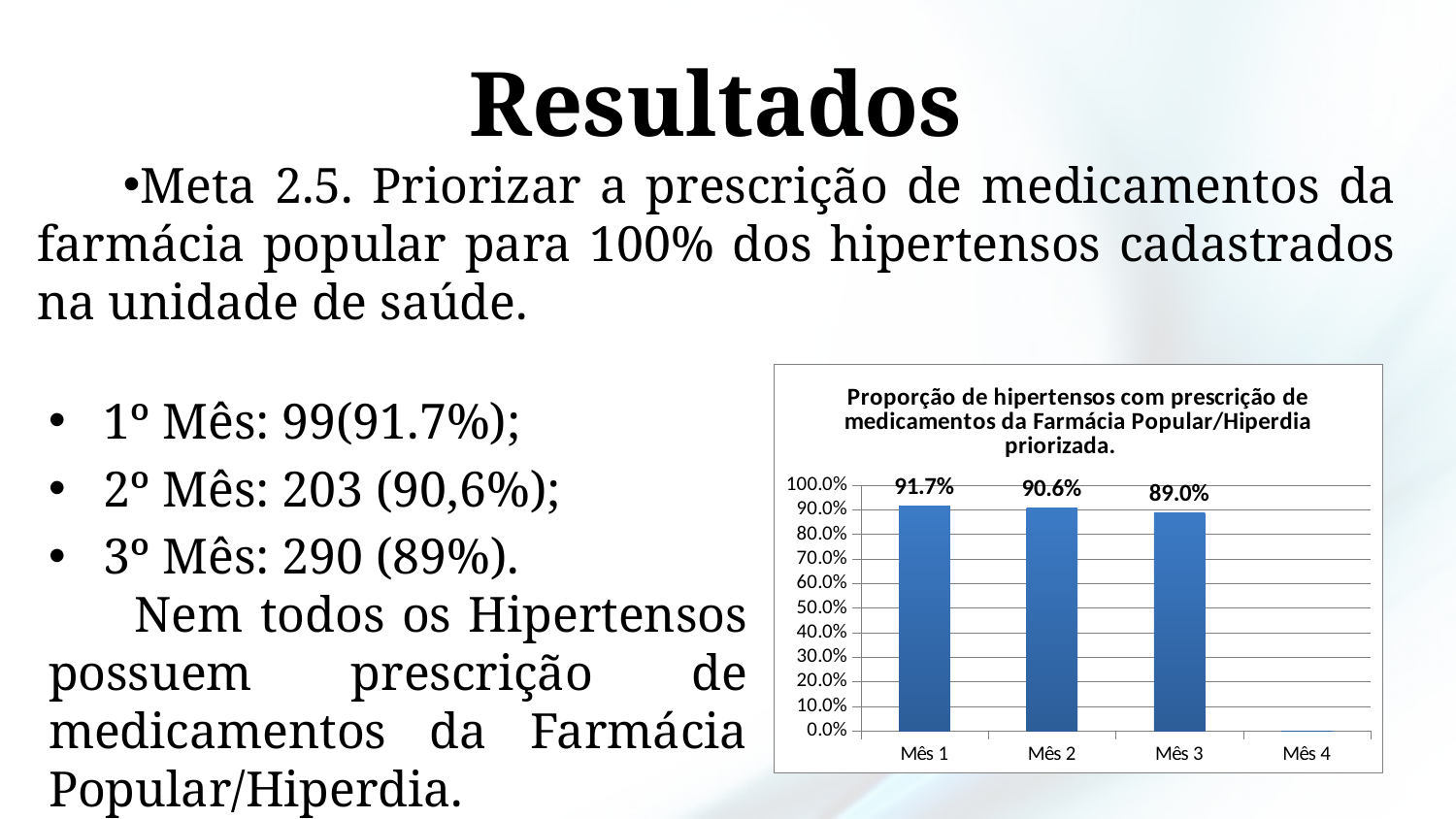
What kind of chart is shown on the slide? Bar chart Do the values rise or fall from Mês 1 to Mês 3? Fall What is the value for Mês 1? 91.7% Which is larger, the value for Mês 2 or the value for Mês 3? Mês 2 What is the value for Mês 2? 90.6% Which month has the highest value? Mês 1 What is the difference between the values for Mês 1 and Mês 2? 1.1 percentage points Is the value for Mês 3 greater or less than 80.0%? greater Which of the plotted months has the lowest value? Mês 3 How many bars are plotted in the chart? 3 What is the value for Mês 3? 89.0% What is the difference between the values for Mês 1 and Mês 3? 2.7 percentage points